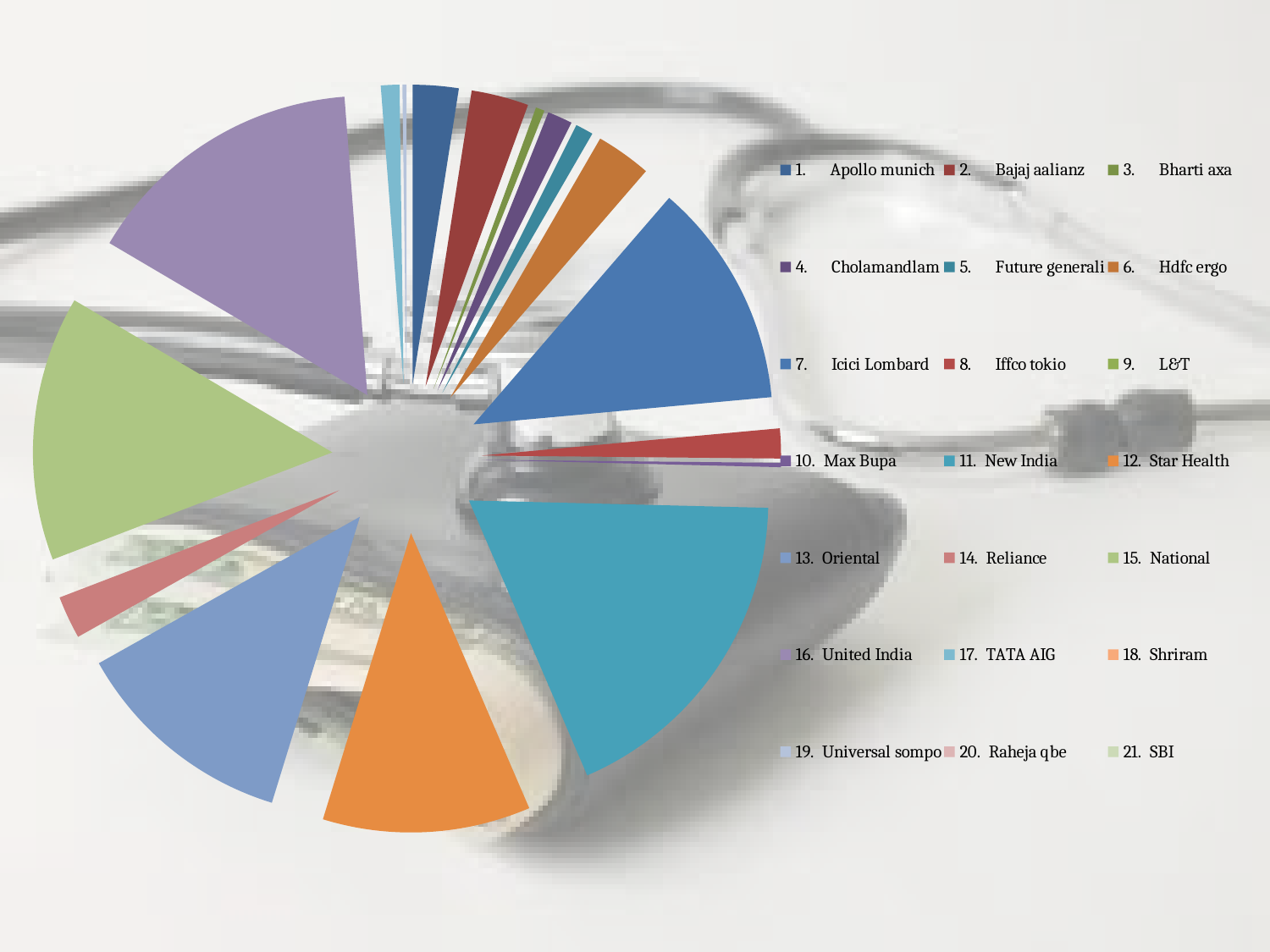
Which category is listed as number 21 in the legend? SBI Which slice is larger, Star Health or Bajaj aalianz? Star Health How many categories does the legend of the pie chart list? 21 Which slice is larger, Icici Lombard or Iffco tokio? Icici Lombard Which category is listed as number 12 in the legend? Star Health Which slice is larger, New India or Reliance? New India What kind of chart is shown on the slide? pie chart Which category has the largest slice in the pie chart? New India